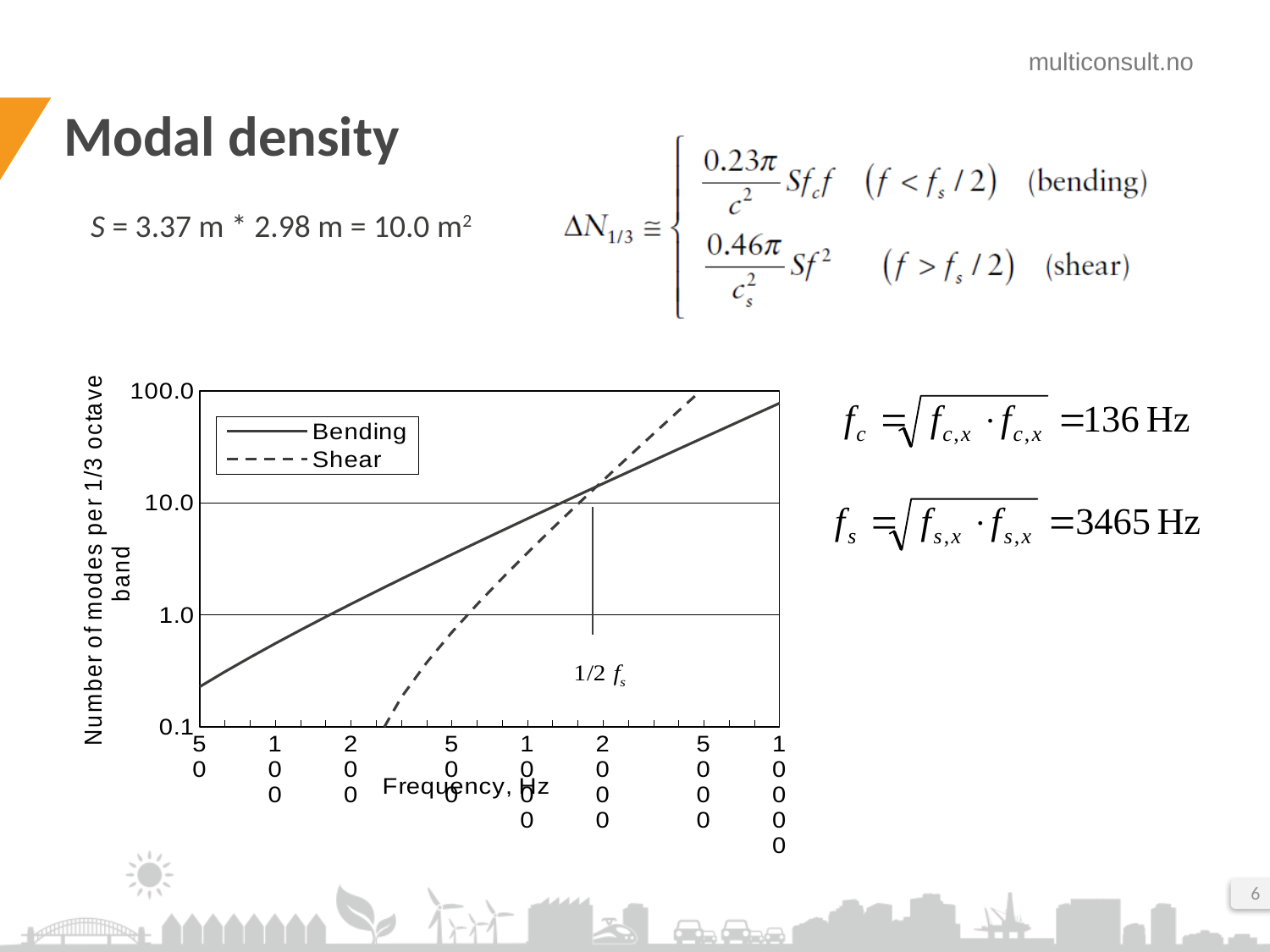
Is the Bending value at 10000 Hz greater or less than 10.0? greater Is the Shear value at 5000 Hz greater or less than 10.0? greater What kind of chart is shown on the slide? line chart Does the Shear curve rise or fall as frequency increases along the x axis? rise What is the x-axis title of the chart? Frequency, Hz At 100 Hz, which series has the higher value, Bending or Shear? Bending Does the Bending curve rise or fall as frequency increases along the x axis? rise Is the Bending value at 50 Hz greater or less than 1.0? less At 5000 Hz, which series has the higher value, Bending or Shear? Shear How many series does the chart legend list? 2 What are the two series named in the chart legend? Bending and Shear